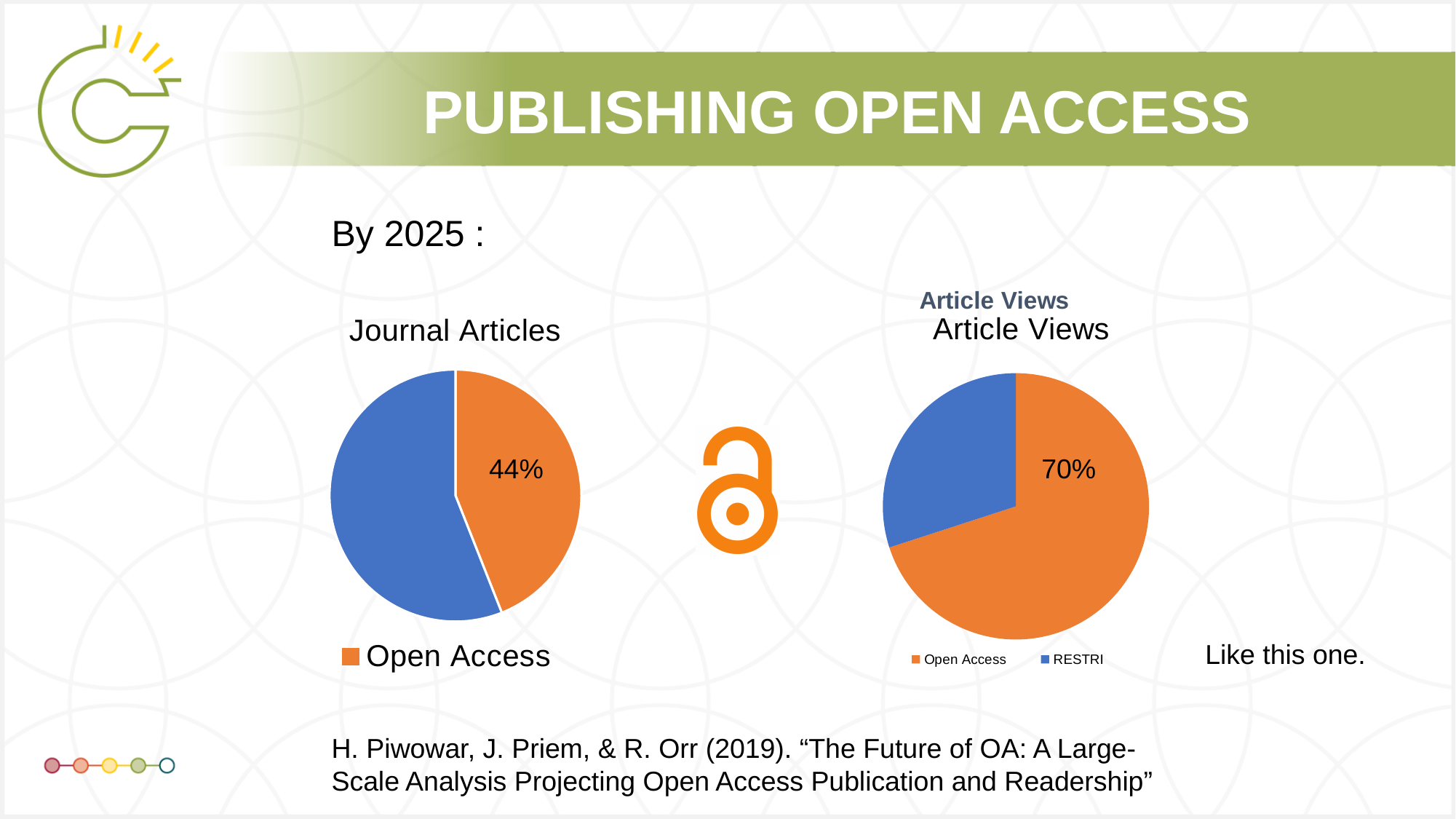
What kind of chart is the Article Views chart? Pie chart In the Article Views chart, what colour is the Open Access slice? Orange How many slices does the Article Views pie chart have? 2 In the Journal Articles chart, which slice is larger, the orange Open Access slice or the blue slice? The blue slice In the Article Views chart, which slice is larger, Open Access or RESTRI? Open Access How many percentage points higher is the Open Access share in the Article Views chart than in the Journal Articles chart? 26 percentage points How many slices does the Journal Articles pie chart have? 2 In the Journal Articles chart, what share of journal articles is Open Access? 44% What kind of chart is the Journal Articles chart? Pie chart Is the Open Access share larger in the Journal Articles chart or in the Article Views chart? Article Views In the Article Views chart, what share of article views is Open Access? 70% In the Article Views chart, how many entries does the legend list? 2